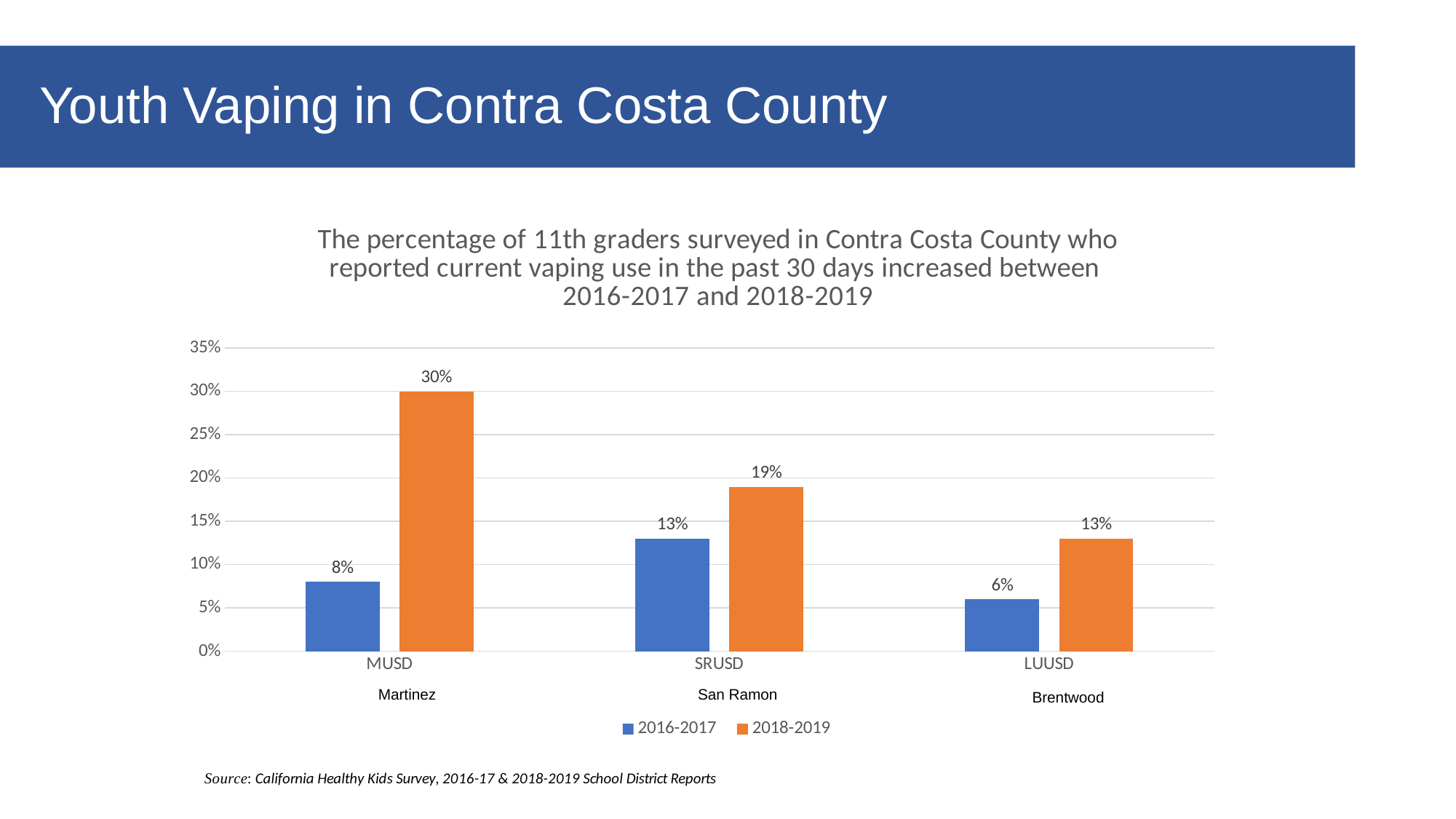
What is the 2016-2017 value for LUUSD? 6% How many series does the legend list? 2 Which district has the highest 2018-2019 value? MUSD What is the 2016-2017 value for SRUSD? 13% Which district has the lowest 2016-2017 value? LUUSD What is the difference between the 2018-2019 and 2016-2017 values for MUSD? 22% What is the 2018-2019 value for SRUSD? 19% Which is larger: the 2018-2019 value for SRUSD or the 2018-2019 value for LUUSD? SRUSD How many districts are shown on the x axis? 3 What kind of chart is shown on the slide? Bar chart Which colour represents the 2018-2019 series? Orange What is the 2018-2019 value for MUSD? 30%